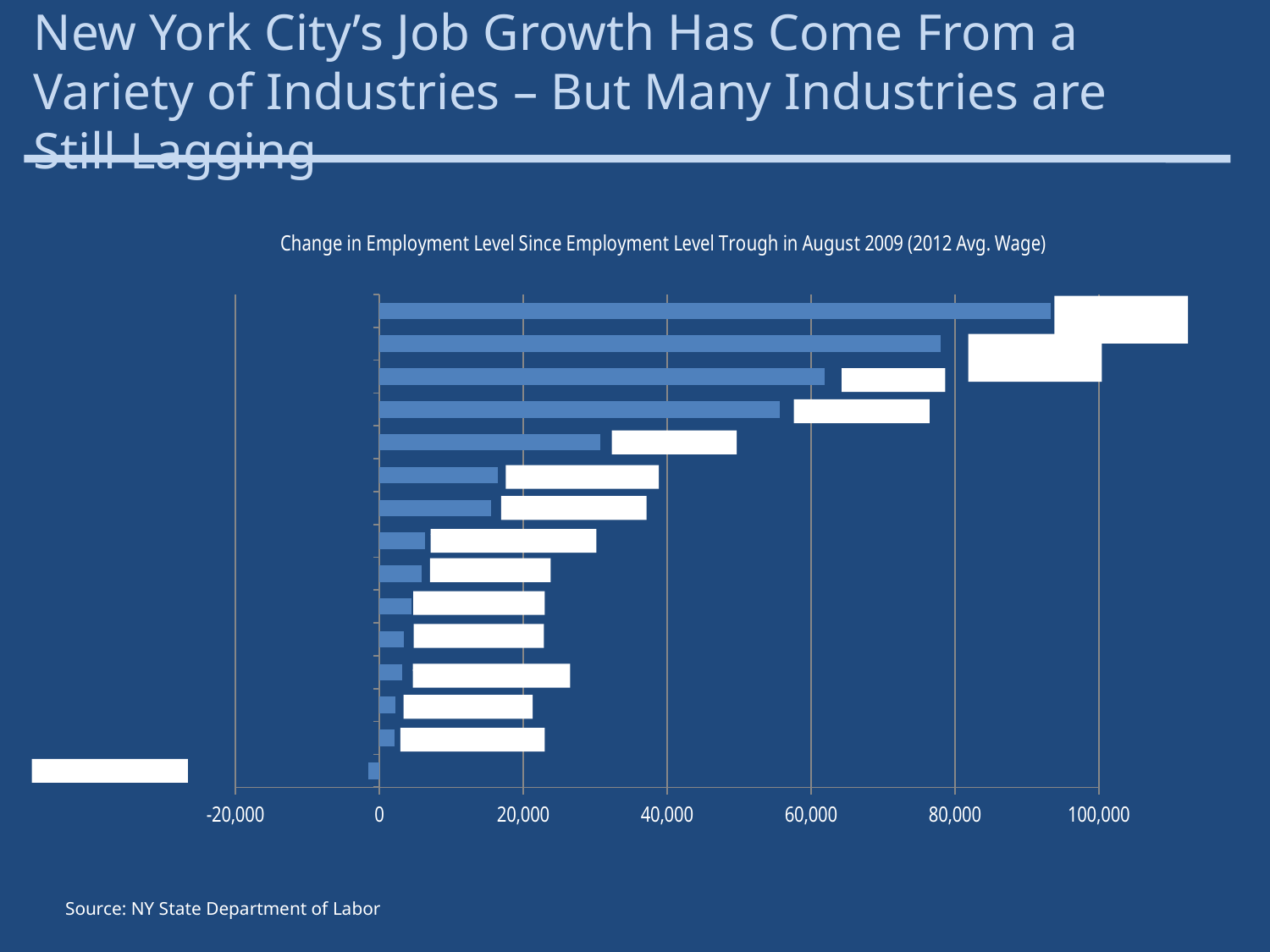
Do the bar values rise or fall when reading from the top of the chart to the bottom? Fall Which bar has the highest value, the top bar or the bottom bar? The top bar What is the lowest value shown on the horizontal axis? -20,000 What kind of chart is shown on the slide? Bar chart What is the title of the chart? Change in Employment Level Since Employment Level Trough in August 2009 (2012 Avg. Wage) Is the value of the longest (top) bar greater or less than 80,000? greater Is the value of the fifth bar from the top greater or less than 40,000? less Is the value of the bottom bar greater or less than 0? less How many bars are plotted in the chart? 15 How many bars in the chart have a negative value? 1